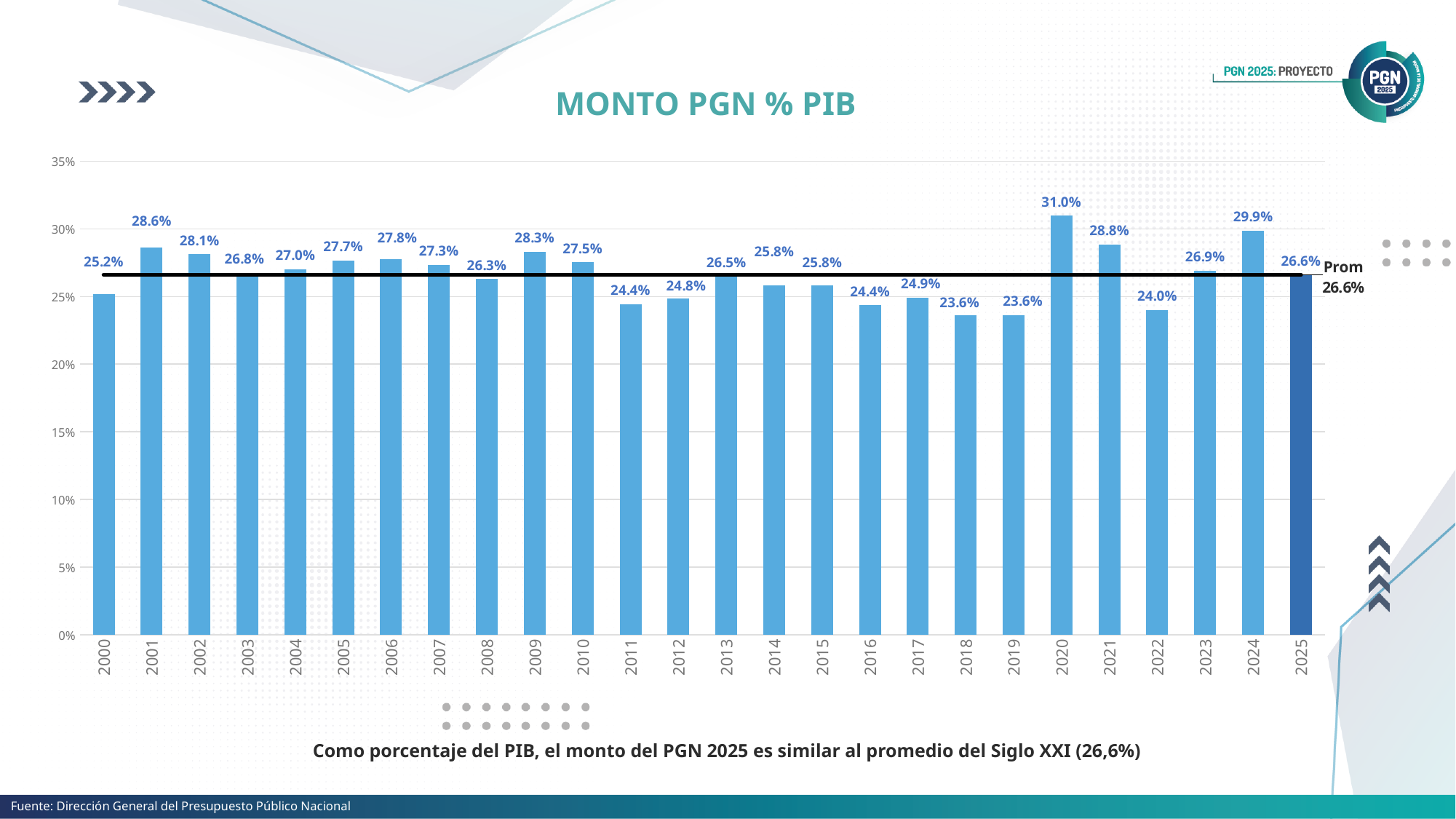
What is the lowest value shown on the chart? 23.6% What is the difference between the values for 2020 and 2025? 4.4 percentage points Which is larger, the value for 2009 or the value for 2010? 2009 What value does the horizontal line labelled 'Prom' mark? 26.6% Do the values rise or fall from 2020 to 2022? fall What is the value for 2025? 26.6% What kind of chart is this? bar chart Which year has the highest value? 2020 Is the value for 2018 greater or less than 25%? less What is the value for 2011? 24.4% What is the value for 2020? 31.0% How many years are shown on the x axis? 26